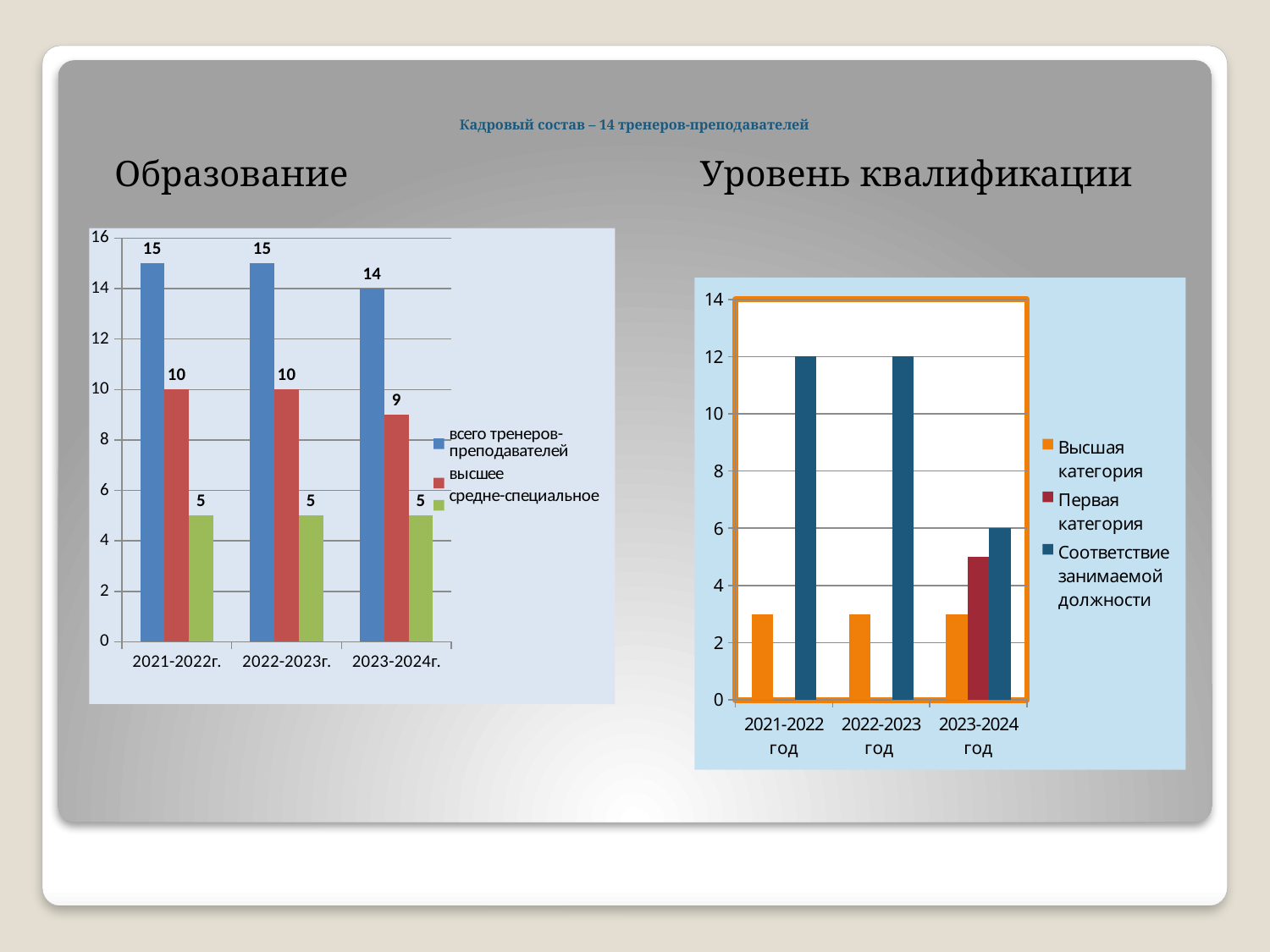
In the 'Уровень квалификации' chart, what is the value for 'Соответствие занимаемой должности' in 2023-2024 год? 6 What kind of chart is the 'Уровень квалификации' chart? bar chart In the 'Образование' chart, which year has the lowest value for 'высшее'? 2023-2024г. In the 'Образование' chart, what is the value for 'высшее' in 2021-2022г.? 10 In the 'Образование' chart, what is the value for 'всего тренеров-преподавателей' in 2023-2024г.? 14 In the 'Уровень квалификации' chart, is the value for 'Высшая категория' in 2021-2022 год greater or less than 4? less In the 'Образование' chart, what is the value for 'средне-специальное' in 2022-2023г.? 5 In the 'Уровень квалификации' chart, what is the value for 'Соответствие занимаемой должности' in 2021-2022 год? 12 In the 'Образование' chart, what is the difference between 'всего тренеров-преподавателей' and 'высшее' in 2023-2024г.? 5 In the 'Образование' chart, does the value for 'всего тренеров-преподавателей' rise or fall from 2022-2023г. to 2023-2024г.? fall In the 'Уровень квалификации' chart, which series is larger in 2023-2024 год: 'Первая категория' or 'Соответствие занимаемой должности'? Соответствие занимаемой должности In the 'Образование' chart, how many series does the legend list? 3